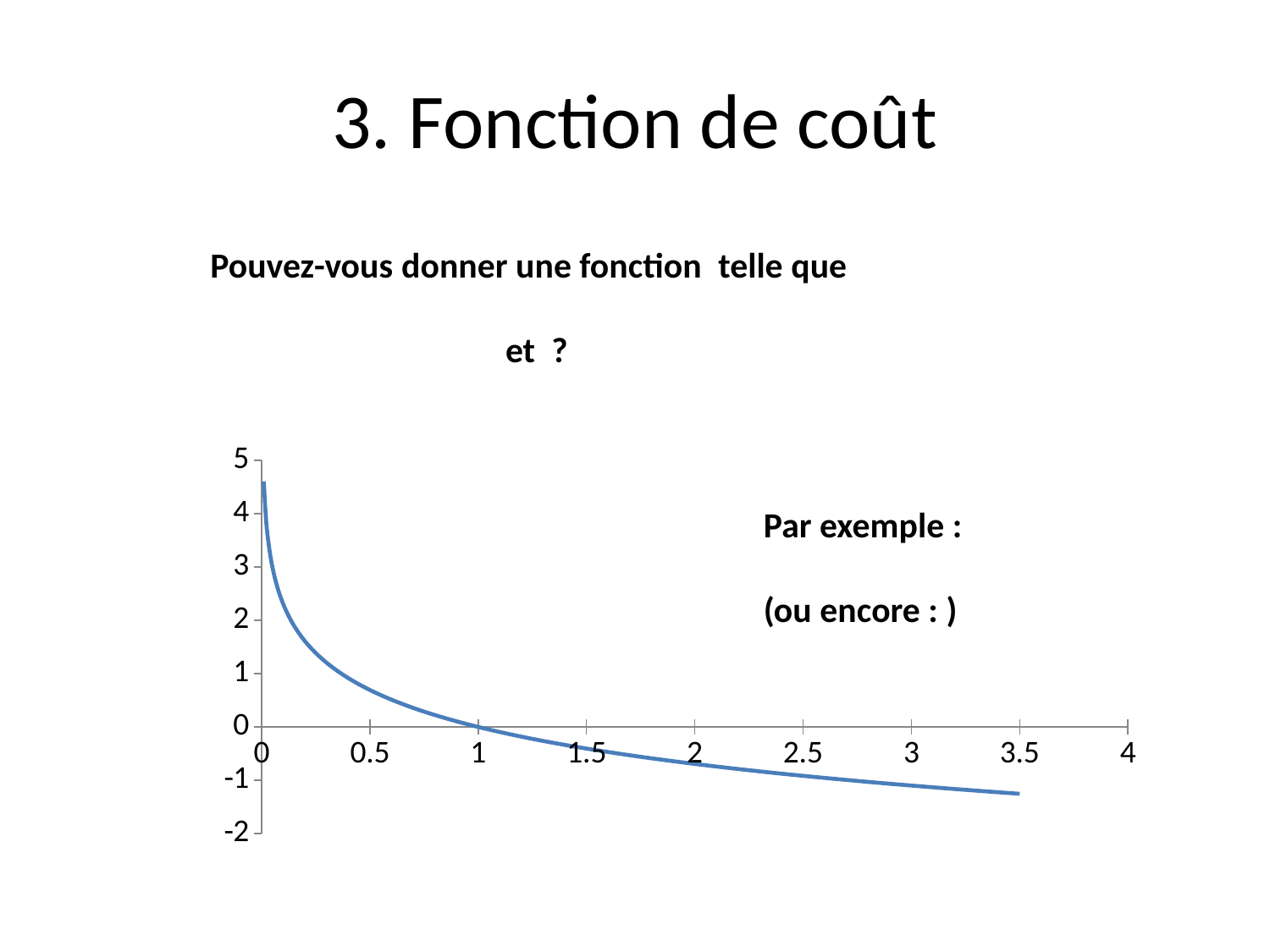
What is the highest tick value shown on the vertical axis? 5 Is the value of the curve at x = 0.5 greater or less than 1? less Is the value of the curve at x = 0.5 greater or less than 0? greater How many lines (series) are plotted on the chart? 1 Which is larger, the value of the curve at x = 0.5 or at x = 2.5? x = 0.5 Do the values of the curve rise or fall as x increases along the horizontal axis? fall Is the value of the curve near x = 0 greater or less than 3? greater At what x value does the curve cross the horizontal axis (y = 0)? 1 What kind of chart is shown on the slide? line chart